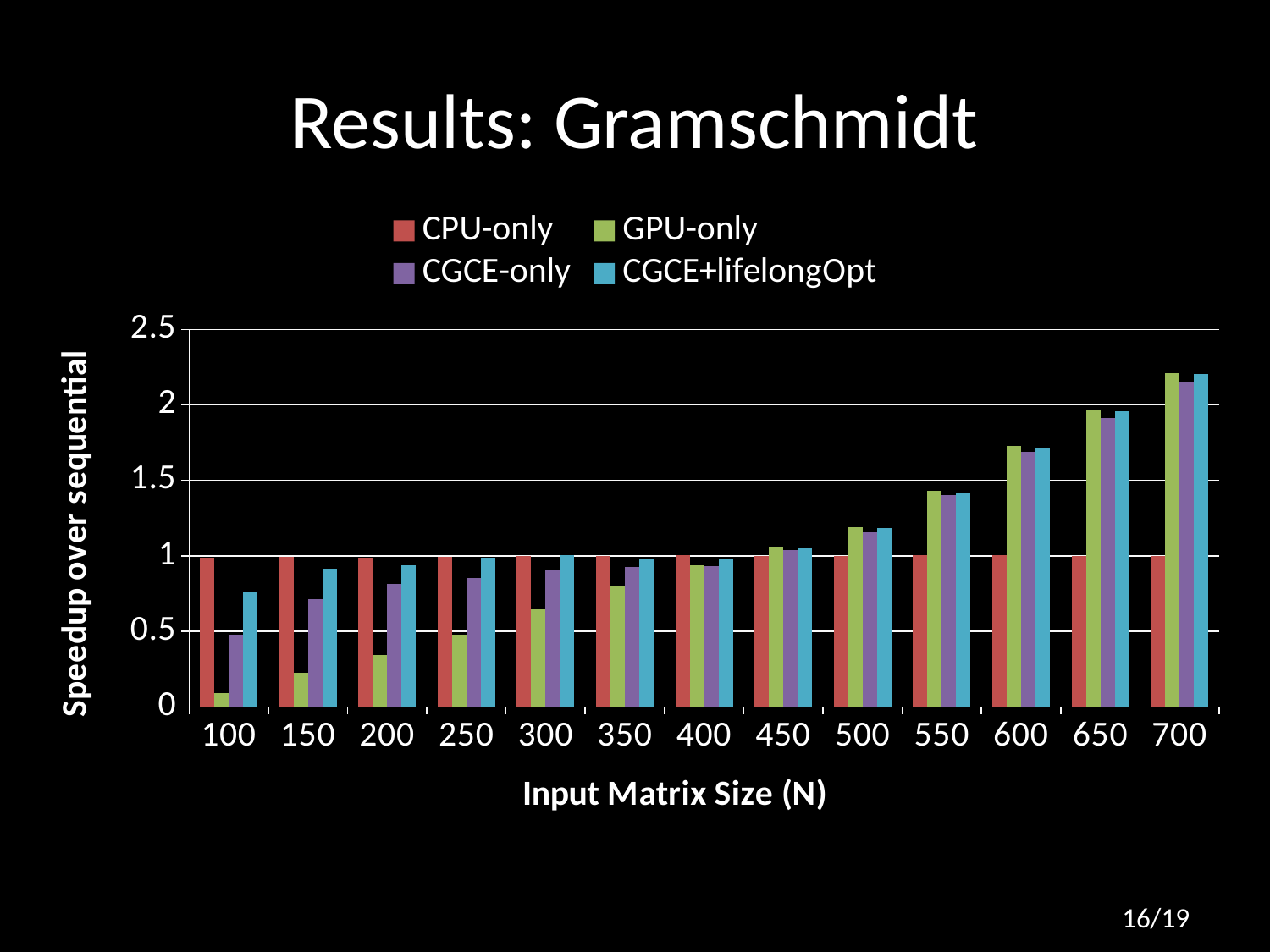
At which input matrix size is the GPU-only speedup highest? 700 Is the GPU-only value at input matrix size 700 greater or less than 2? greater Does the GPU-only speedup rise or fall as the input matrix size increases? rise At input matrix size 200, which is larger: CPU-only or GPU-only? CPU-only Is the CGCE+lifelongOpt value at input matrix size 100 greater or less than 0.5? greater Is the GPU-only value at input matrix size 100 greater or less than 0.5? less How many input matrix sizes are shown on the x axis? 13 At which input matrix size is the GPU-only speedup lowest? 100 What kind of chart is shown on the slide? bar chart How many series does the legend list? 4